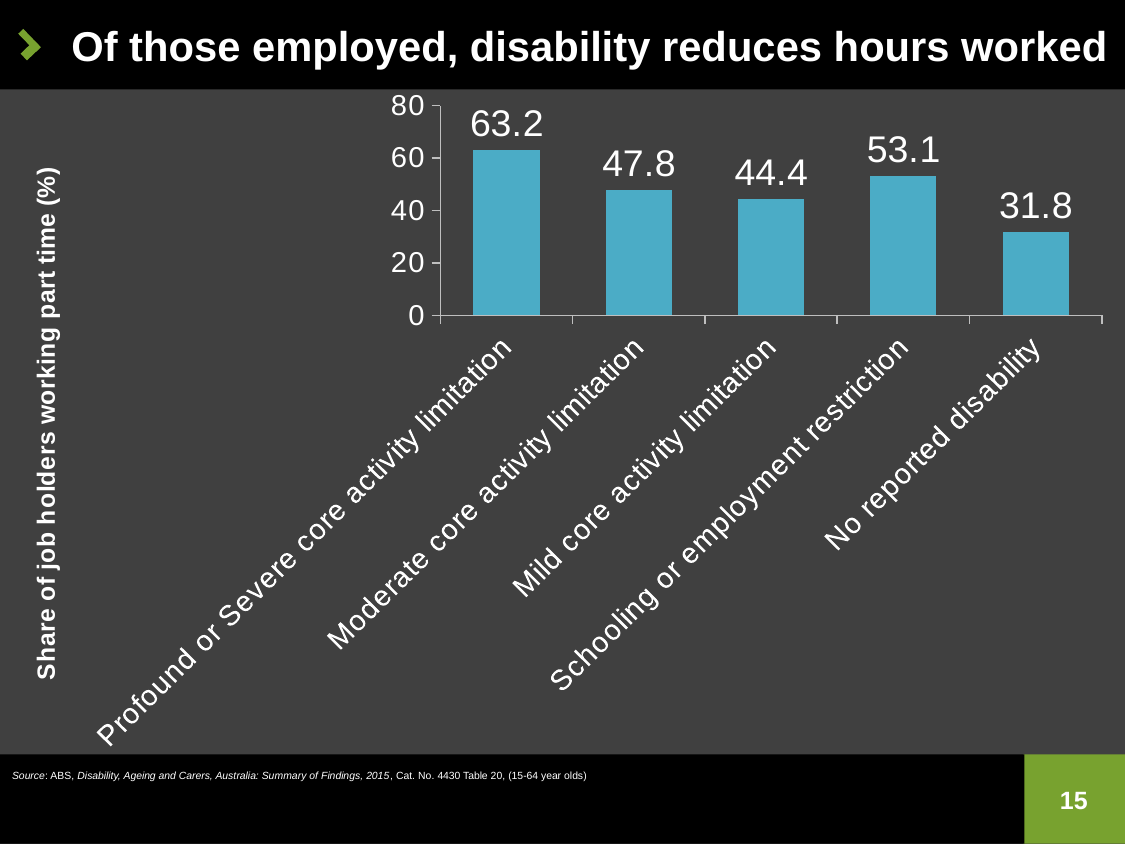
What is the share of job holders working part time for Profound or Severe core activity limitation? 63.2 What is the value for Mild core activity limitation? 44.4 Is the value for Schooling or employment restriction greater or less than 40? greater What is the value for No reported disability? 31.8 What kind of chart is shown on the slide? Bar chart What is the value for Schooling or employment restriction? 53.1 Which is larger, the value for Moderate core activity limitation or Mild core activity limitation? Moderate core activity limitation What is the difference between the values for Profound or Severe core activity limitation and No reported disability? 31.4 How many categories are shown on the chart? 5 What is the label on the vertical axis of the chart? Share of job holders working part time (%) Which category has the highest share of job holders working part time? Profound or Severe core activity limitation Which category has the lowest share of job holders working part time? No reported disability